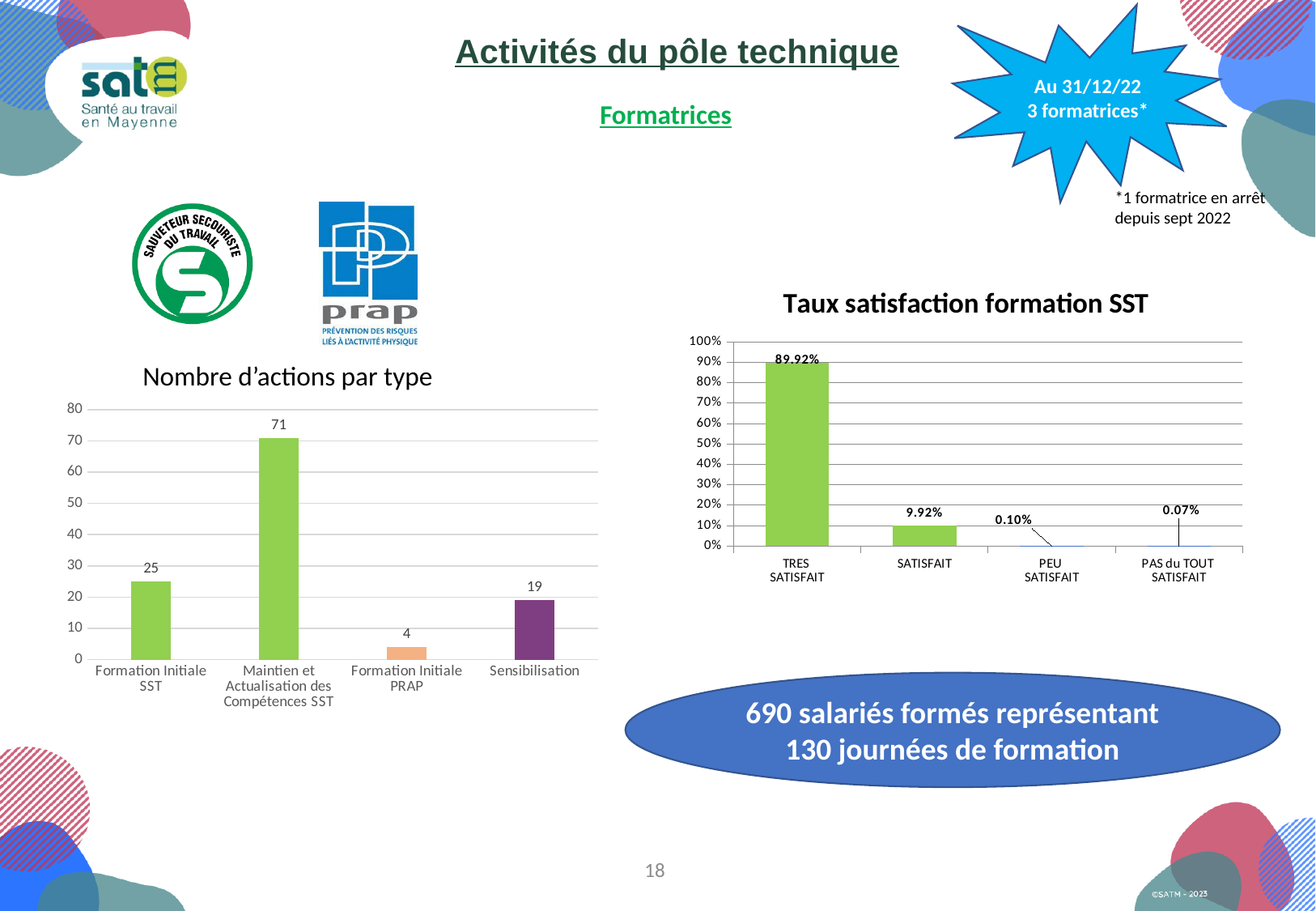
In the 'Nombre d'actions par type' chart, what is the difference between Formation Initiale SST and Sensibilisation? 6 In the 'Taux satisfaction formation SST' chart, what is the difference between TRES SATISFAIT and SATISFAIT? 80.00% In the 'Taux satisfaction formation SST' chart, which is larger, SATISFAIT or PEU SATISFAIT? SATISFAIT In the 'Nombre d'actions par type' chart, what is the value for Formation Initiale PRAP? 4 In the 'Taux satisfaction formation SST' chart, what is the value for TRES SATISFAIT? 89.92% In the 'Nombre d'actions par type' chart, which category has the highest value? Maintien et Actualisation des Compétences SST In the 'Nombre d'actions par type' chart, which category has the lowest value? Formation Initiale PRAP In the 'Taux satisfaction formation SST' chart, what is the value for PEU SATISFAIT? 0.10% In the 'Taux satisfaction formation SST' chart, which category has the lowest value? PAS du TOUT SATISFAIT In the 'Nombre d'actions par type' chart, what is the value for Maintien et Actualisation des Compétences SST? 71 In the 'Nombre d'actions par type' chart, how many categories are shown? 4 What type of chart is 'Taux satisfaction formation SST'? Bar chart